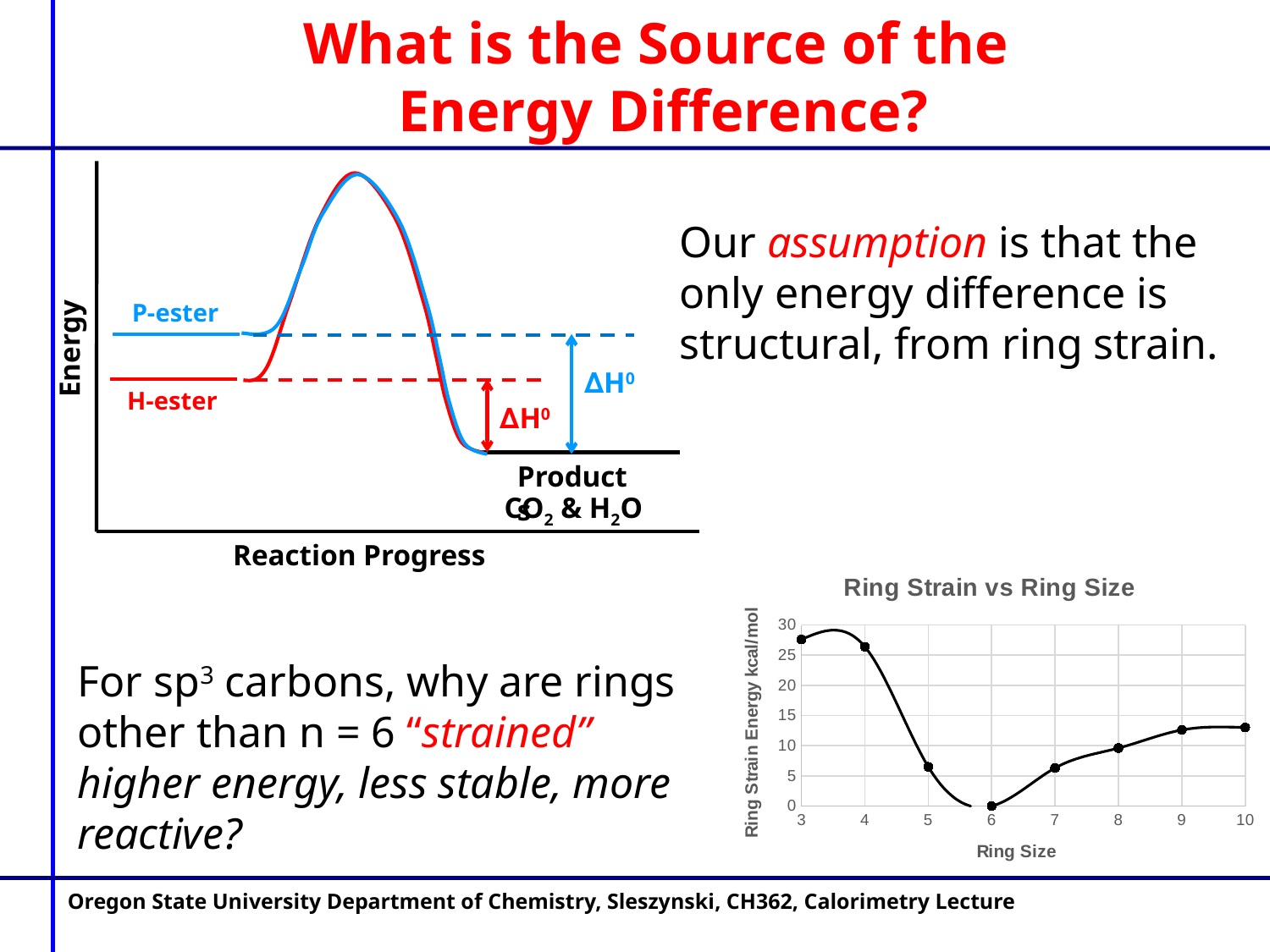
In the Ring Strain vs Ring Size chart, what is the ring strain energy for ring size 6? 0 In the Ring Strain vs Ring Size chart, which ring size has the lowest ring strain energy? 6 What is the y-axis label of the Ring Strain vs Ring Size chart? Ring Strain Energy kcal/mol In the Ring Strain vs Ring Size chart, is the ring strain energy for ring size 5 greater or less than 10? less In the Ring Strain vs Ring Size chart, which has the larger ring strain energy, ring size 3 or ring size 5? Ring size 3 In the Ring Strain vs Ring Size chart, is the ring strain energy for ring size 9 greater or less than 10? greater In the Ring Strain vs Ring Size chart, which has the larger ring strain energy, ring size 7 or ring size 10? Ring size 10 How many data points are plotted in the Ring Strain vs Ring Size chart? 8 In the Ring Strain vs Ring Size chart, does the ring strain energy rise or fall as ring size goes from 6 to 10? Rise What kind of chart is the Ring Strain vs Ring Size chart? Line chart In the Ring Strain vs Ring Size chart, which ring size has the highest ring strain energy? 3 In the Ring Strain vs Ring Size chart, is the ring strain energy for ring size 3 greater or less than 25? greater